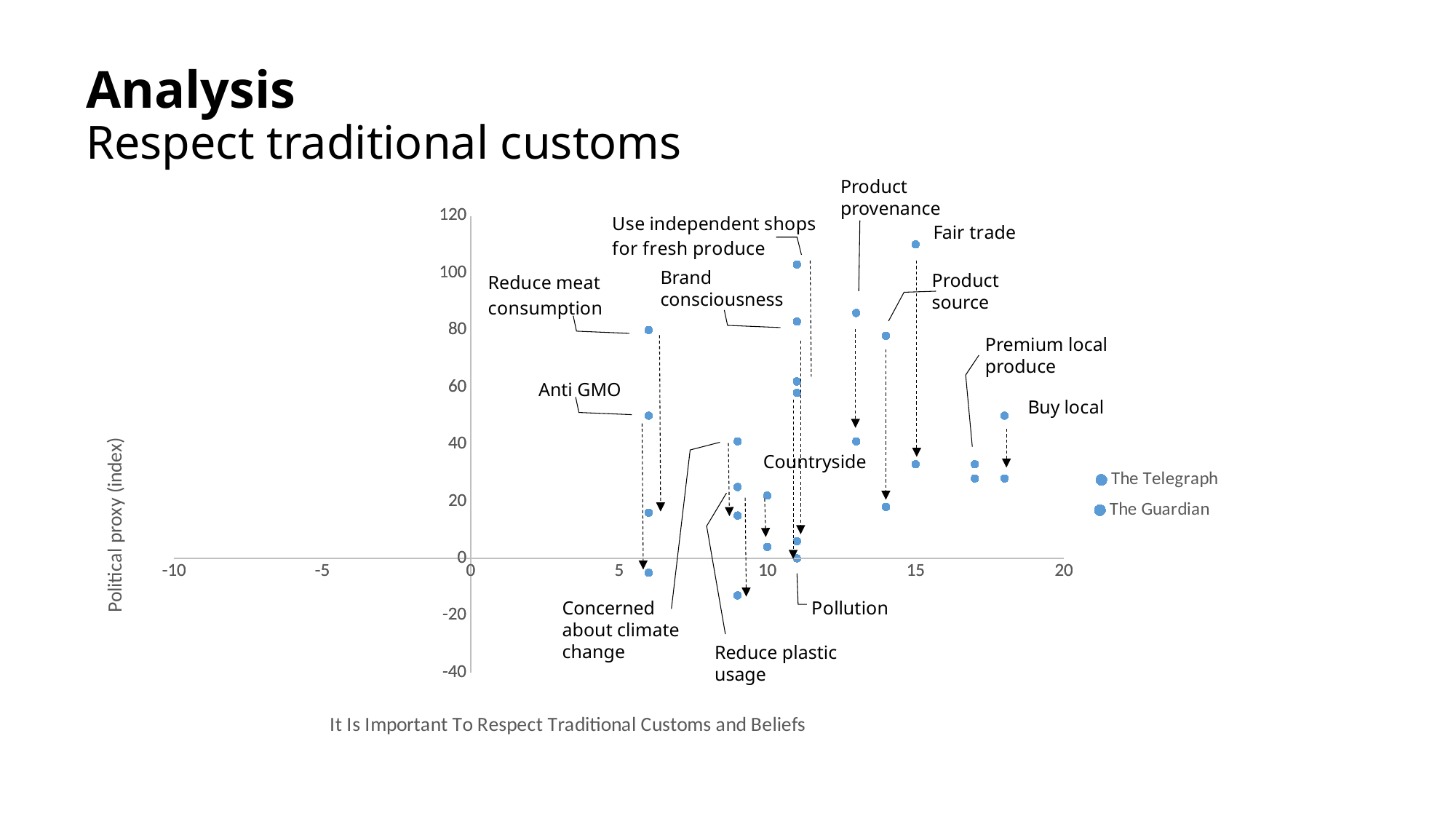
Which has the higher top point, Fair trade or Buy local? Fair trade Which labelled item has the highest point on the chart? Fair trade Are both values for Premium local produce greater or less than 40? less Which labelled item has the lowest point on the chart? Reduce plastic usage How many labelled items (attitudes) are annotated on the chart? 13 What is the title of the vertical axis? Political proxy (index) Is the lowest value for Reduce plastic usage greater or less than 0? less Is the highest value for Fair trade greater or less than 100? greater How many series does the legend list? 2 What are the two series named in the legend? The Telegraph and The Guardian What kind of chart is shown on the slide? scatter chart